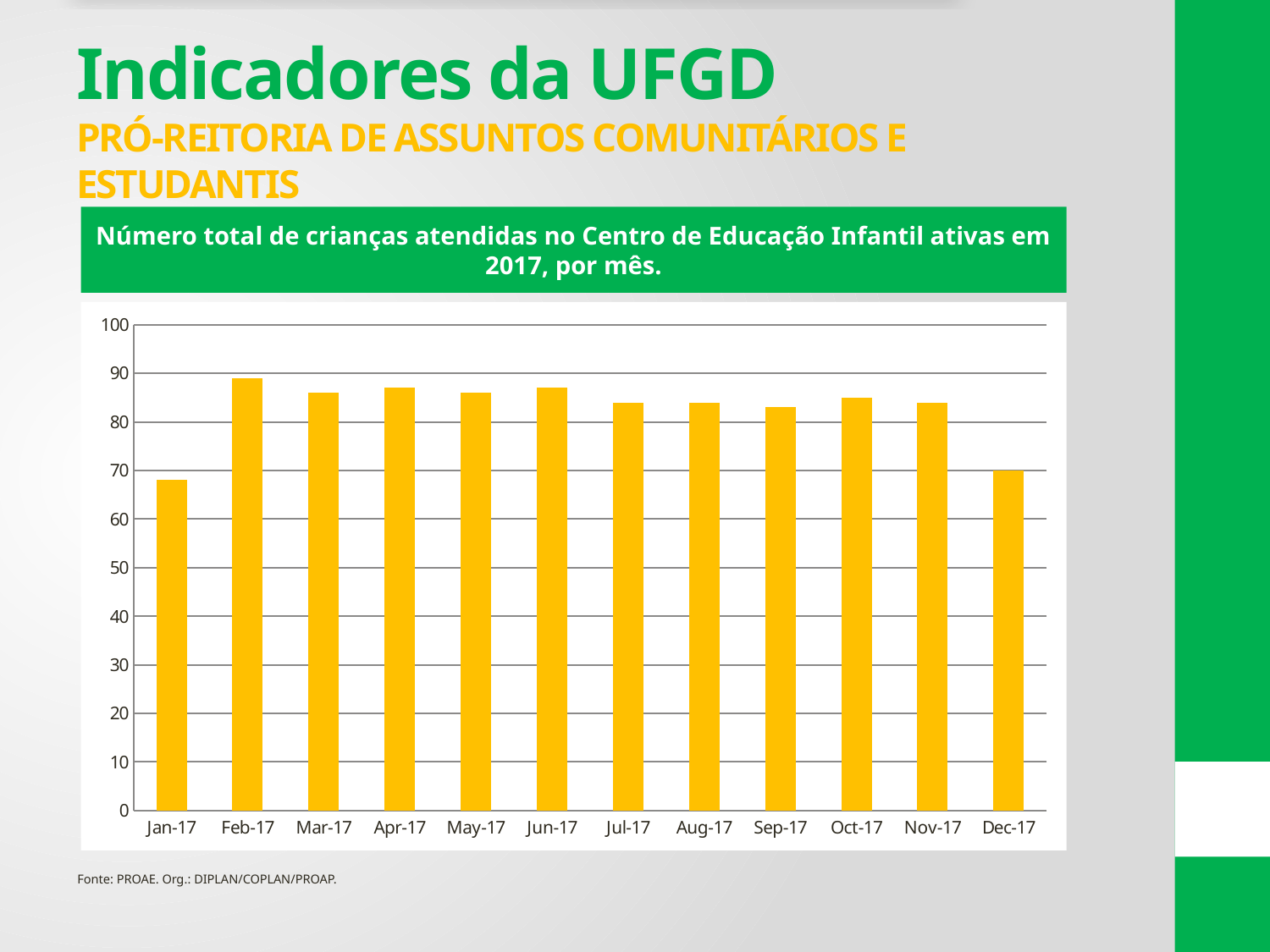
What kind of chart is shown on the slide? bar chart Is the value for Feb-17 greater or less than 80? greater Which month has the lowest number of children attended? Jan-17 What is the title of the chart? Número total de crianças atendidas no Centro de Educação Infantil ativas em 2017, por mês. Is the value for Jan-17 greater or less than 70? less Do the values rise or fall from Jun-17 to Sep-17? fall Is the value for Dec-17 greater or less than 80? less Which month has the highest number of children attended? Feb-17 Which is larger, the value for Feb-17 or the value for Dec-17? Feb-17 How many months are shown on the x axis of the chart? 12 What colour are the bars in the chart? yellow